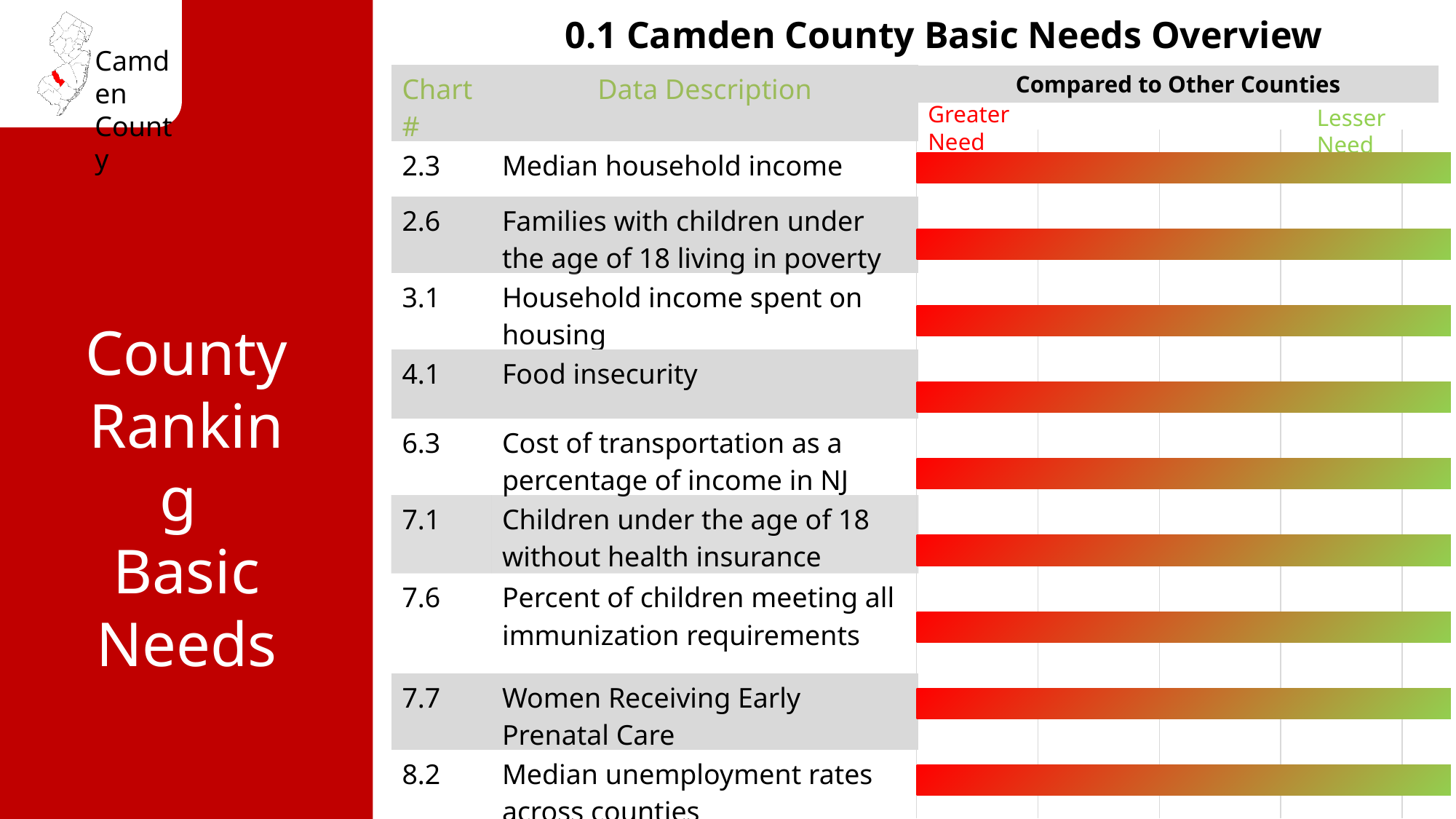
Which data description is listed for chart number 7.7? Women Receiving Early Prenatal Care Which chart number corresponds to 'Food insecurity'? 4.1 Which data description is listed for chart number 8.2? Median unemployment rates across counties What kind of chart is shown on the slide? bar chart How many data description rows (categories) are listed in the chart? 9 Which chart number corresponds to 'Median household income'? 2.3 What is the title of the chart on the slide? 0.1 Camden County Basic Needs Overview What label appears at the left end of the 'Compared to Other Counties' scale? Greater Need